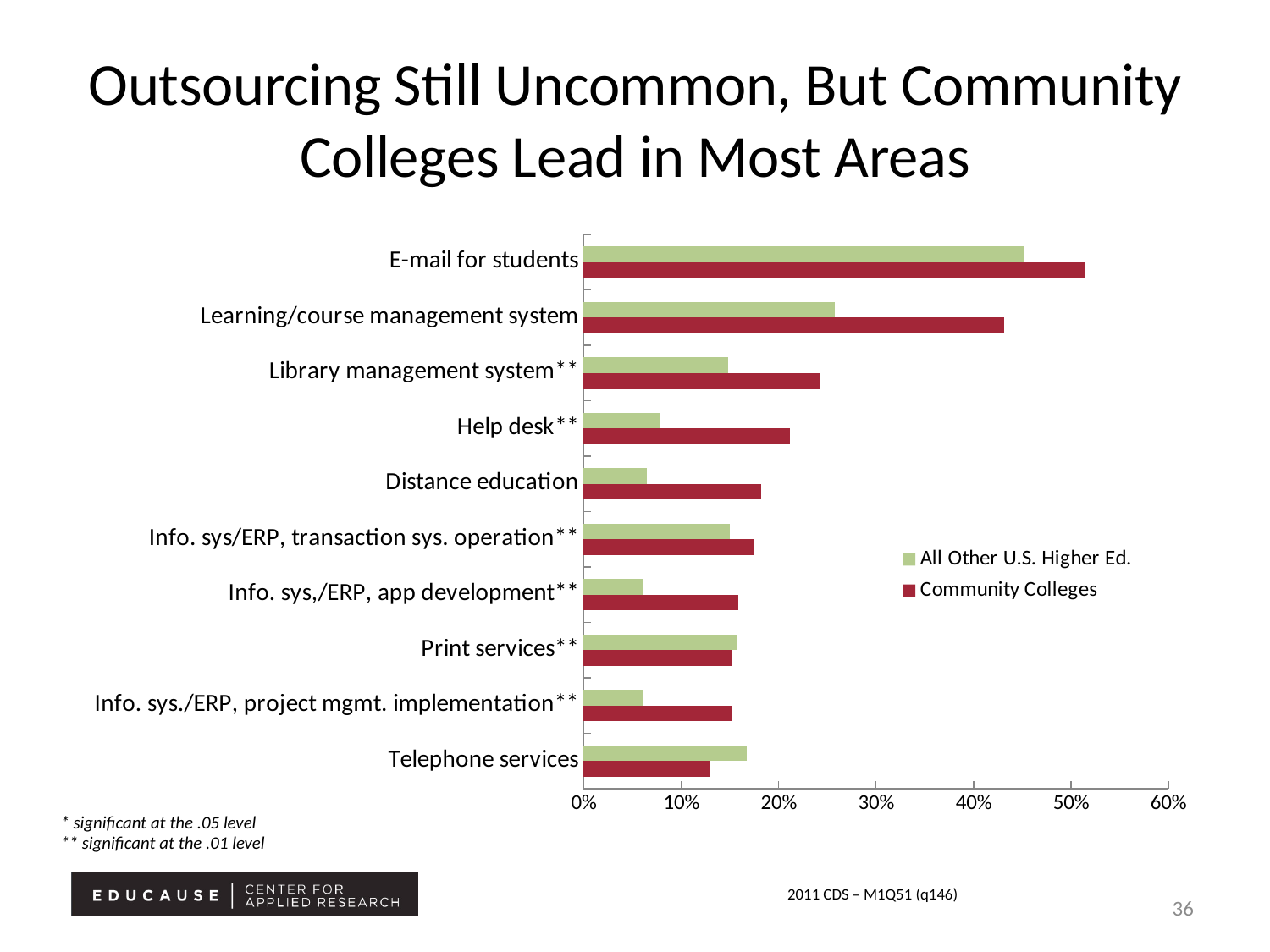
Is the Community Colleges value for E-mail for students greater or less than 40%? greater Is the Community Colleges value for Library management system greater or less than 20%? greater Which category has the highest value for Community Colleges? E-mail for students For Telephone services, which series has the larger value: Community Colleges or All Other U.S. Higher Ed.? All Other U.S. Higher Ed. Is the All Other U.S. Higher Ed. value for Learning/course management system greater or less than 30%? less What kind of chart is shown on the slide? Bar chart What colour represents Community Colleges in the chart? Red How many series does the legend list? 2 Which category has the lowest value for Community Colleges? Telephone services Which category has the highest value for All Other U.S. Higher Ed.? E-mail for students For Help desk, which series has the larger value: Community Colleges or All Other U.S. Higher Ed.? Community Colleges How many service categories are listed on the chart? 10